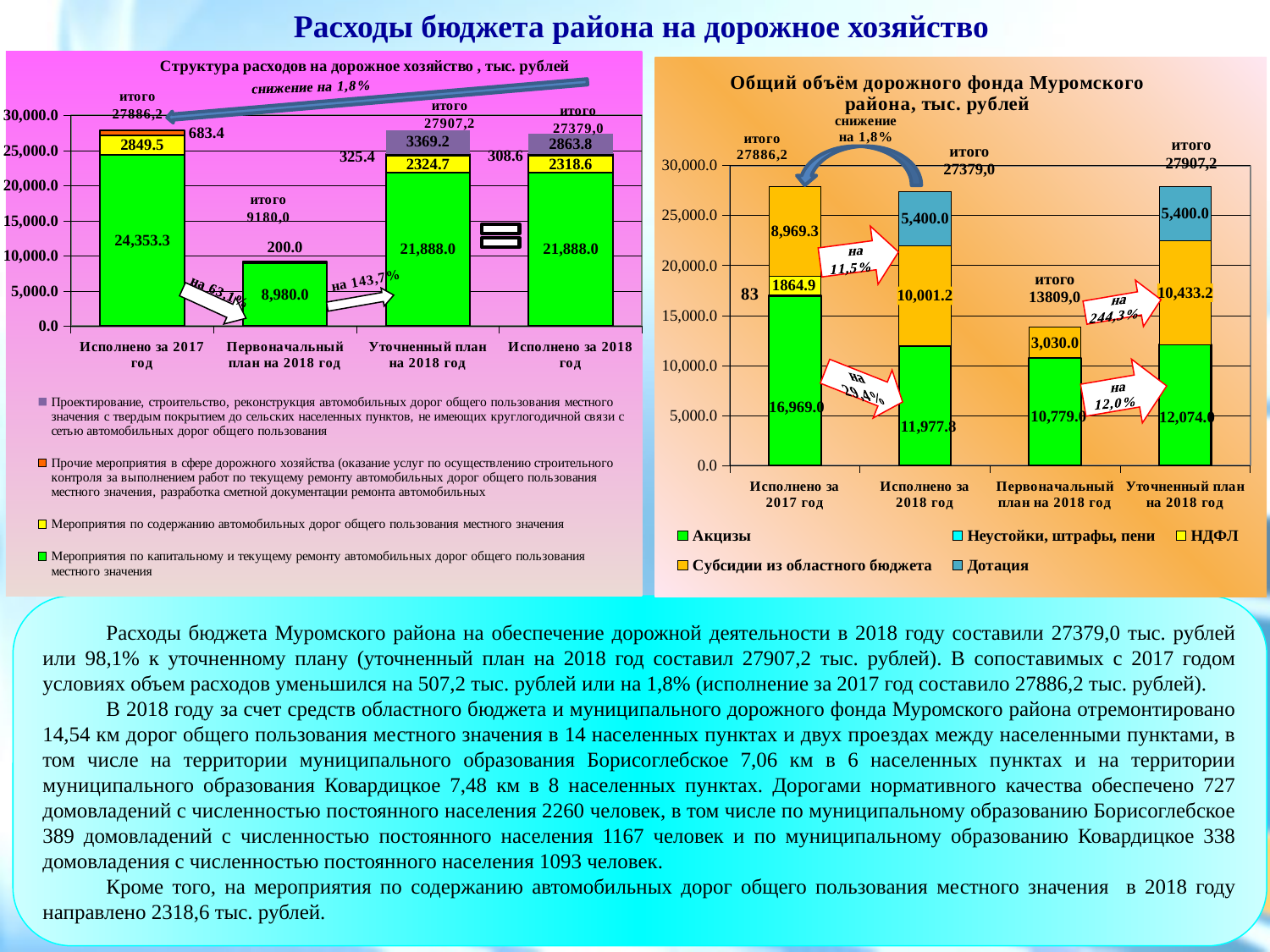
In the right chart 'Общий объём дорожного фонда Муромского района', how many series does the legend list? 5 In the left chart 'Структура расходов на дорожное хозяйство', how many series does the legend list? 4 In the left chart 'Структура расходов на дорожное хозяйство', what is the value of 'Мероприятия по капитальному и текущему ремонту автомобильных дорог' for 'Исполнено за 2017 год'? 24,353.3 In the right chart 'Общий объём дорожного фонда Муромского района', what is the total ('итого') for 'Первоначальный план на 2018 год'? 13809,0 In the left chart 'Структура расходов на дорожное хозяйство', what is the total ('итого') for 'Первоначальный план на 2018 год'? 9180,0 In the left chart 'Структура расходов на дорожное хозяйство', which category has the lowest total? Первоначальный план на 2018 год In the right chart 'Общий объём дорожного фонда Муромского района', which is larger: 'Акцизы' for 'Исполнено за 2017 год' or 'Акцизы' for 'Исполнено за 2018 год'? Исполнено за 2017 год In the left chart 'Структура расходов на дорожное хозяйство', what is the value of 'Мероприятия по содержанию автомобильных дорог' for 'Исполнено за 2018 год'? 2318.6 In the right chart 'Общий объём дорожного фонда Муромского района', what is the value of 'Субсидии из областного бюджета' for 'Уточненный план на 2018 год'? 10,433.2 In the right chart 'Общий объём дорожного фонда Муромского района', what is the value of 'Акцизы' for 'Исполнено за 2017 год'? 16,969.0 What type of chart is the right chart 'Общий объём дорожного фонда Муромского района'? Stacked bar chart In the left chart 'Структура расходов на дорожное хозяйство', what is the difference between the 'Проектирование, строительство, реконструкция...' values for 'Уточненный план на 2018 год' (3369.2) and 'Исполнено за 2018 год' (2863.8)? 505.4